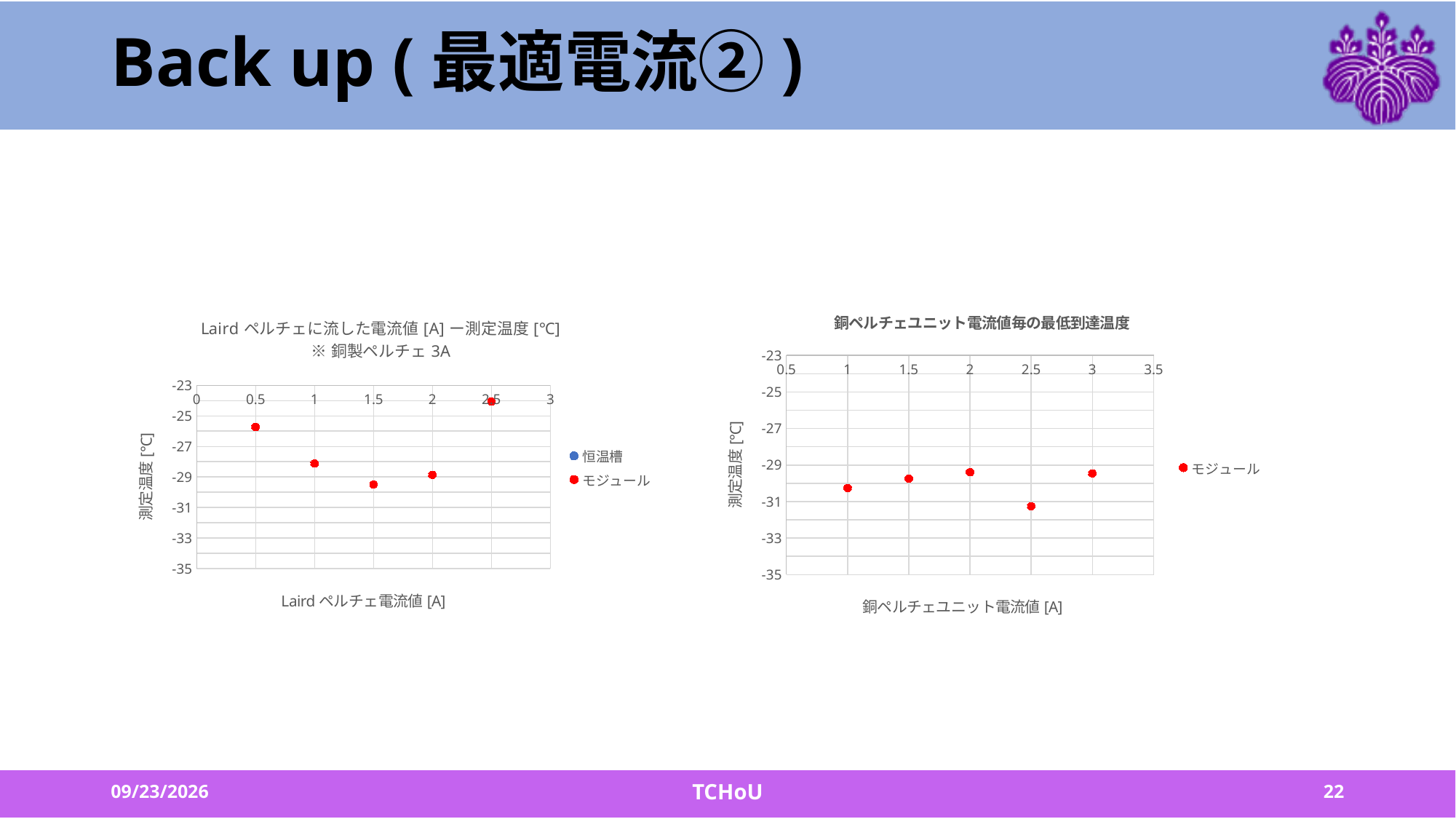
In the left chart (Laird ペルチェ), how many data points are plotted? 5 In the left chart (Laird ペルチェ), is the measured temperature at 1.5 A greater or less than -29? less What type of chart is the left chart titled 'Laird ペルチェに流した電流値 [A] ー測定温度 [℃]'? scatter chart In the right chart titled '銅ペルチェユニット電流値毎の最低到達温度', how many data points are plotted? 5 In the left chart (Laird ペルチェ), at which current value [A] is the measured temperature lowest? 1.5 In the left chart (Laird ペルチェ), how many series does the legend list? 2 In the right chart (銅ペルチェユニット), how many series does the legend list? 1 In the left chart (Laird ペルチェ), is the measured temperature at 0.5 A greater or less than -27? greater In the right chart (銅ペルチェユニット), what is the label of the x axis? 銅ペルチェユニット電流値 [A] In the right chart (銅ペルチェユニット), is the temperature at 2.5 A greater or less than -31? less In the right chart (銅ペルチェユニット), at which current value [A] is the minimum reached temperature lowest? 2.5 In the left chart (Laird ペルチェ), at which current value [A] is the measured temperature highest? 2.5